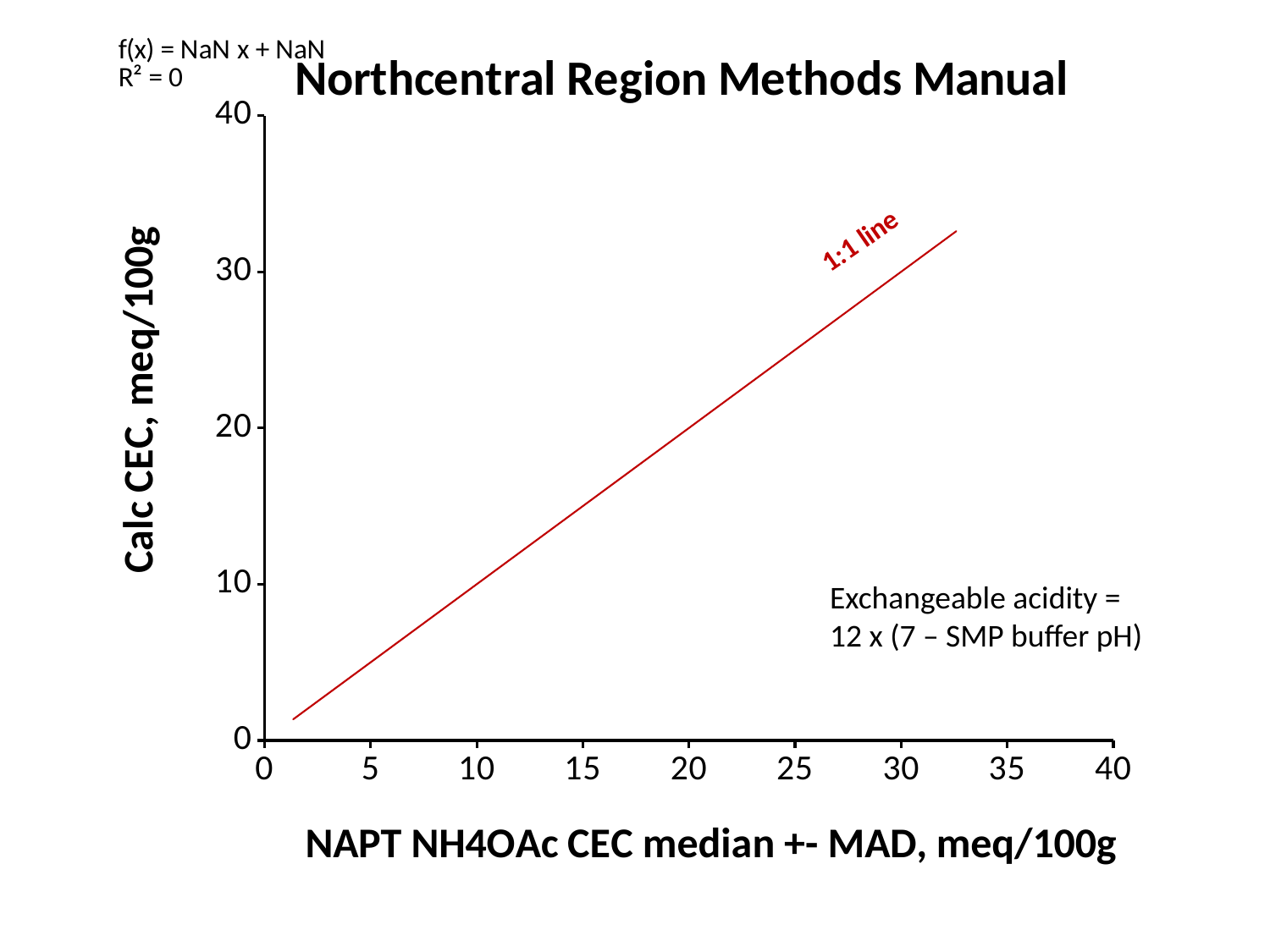
What is the maximum value shown on the x-axis of the chart? 40 What is the maximum value shown on the y-axis of the chart? 40 Does the red 1:1 line rise or fall as the x-axis value increases? rise What label is written on the red line in the chart? 1:1 line What is the title of the chart? Northcentral Region Methods Manual